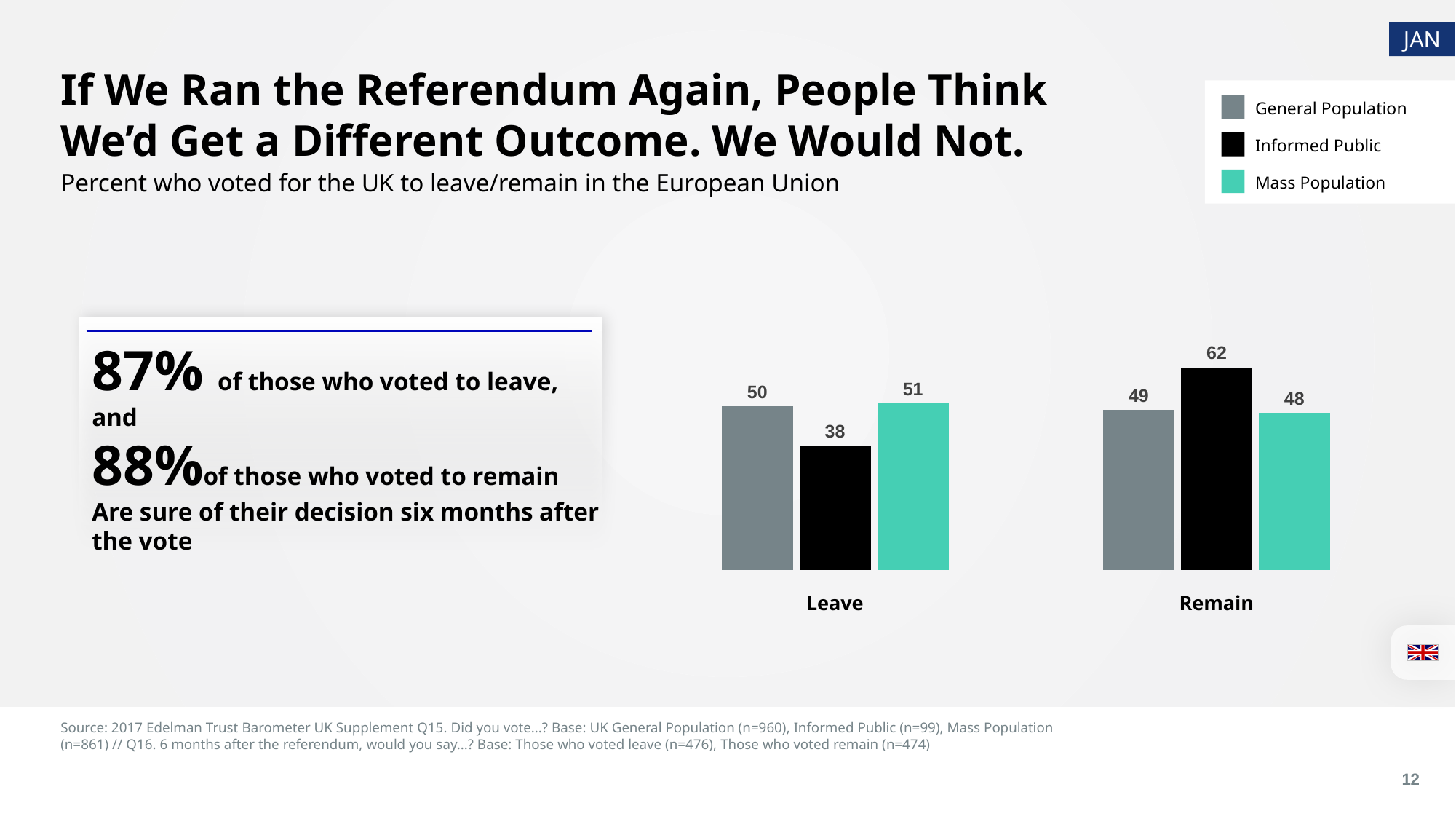
What kind of chart is shown on the slide? Bar chart How many series does the legend list? 3 What is the value for General Population in the Leave category? 50 Which series has the lowest value in the Leave category? Informed Public Which colour represents Mass Population in the legend? Teal What is the value for Mass Population in the Remain category? 48 What is the value for Informed Public in the Leave category? 38 What is the difference between the General Population and Mass Population values in the Leave category? 1 Which is larger: the Informed Public value for Leave or for Remain? Remain Which series has the highest value in the Remain category? Informed Public How many categories are shown on the x axis? 2 What is the difference between the Informed Public values for Remain and Leave? 24